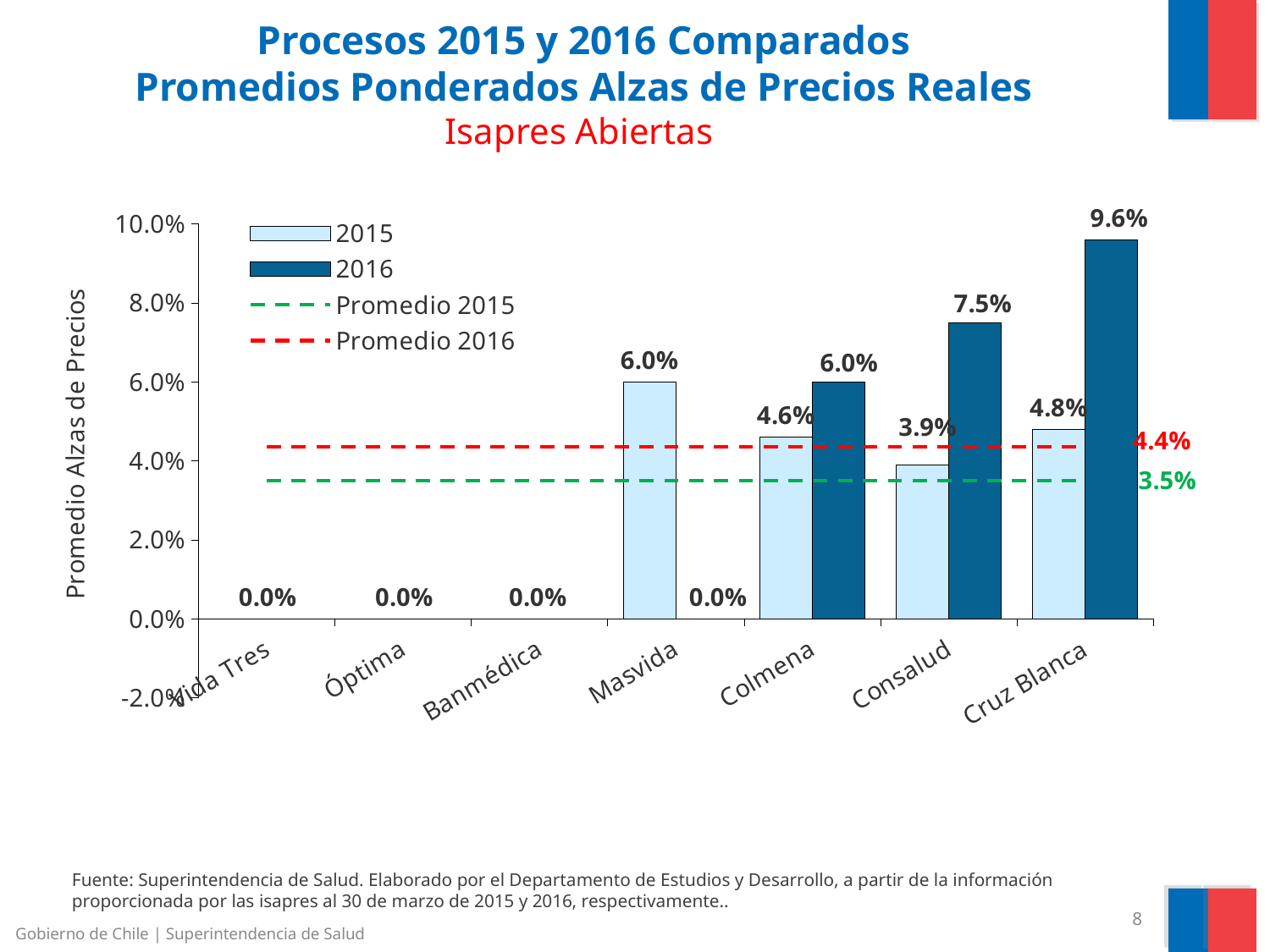
How many isapres are shown on the x axis? 7 Which isapre has the highest value in the 2016 series? Cruz Blanca What is the difference between the 2016 and 2015 values for Consalud? 3.6% What is the value for Masvida in the 2016 series? 0.0% For Colmena, which is larger: the 2015 value or the 2016 value? 2016 What is the value for Cruz Blanca in the 2016 series? 9.6% Which isapre has the highest value in the 2015 series? Masvida What is the value for Consalud in the 2015 series? 3.9% How many series does the legend list? 4 What kind of chart is shown on the slide? Bar chart What value is shown for the Promedio 2016 line? 4.4% What is the difference between the 2016 and 2015 values for Cruz Blanca? 4.8%